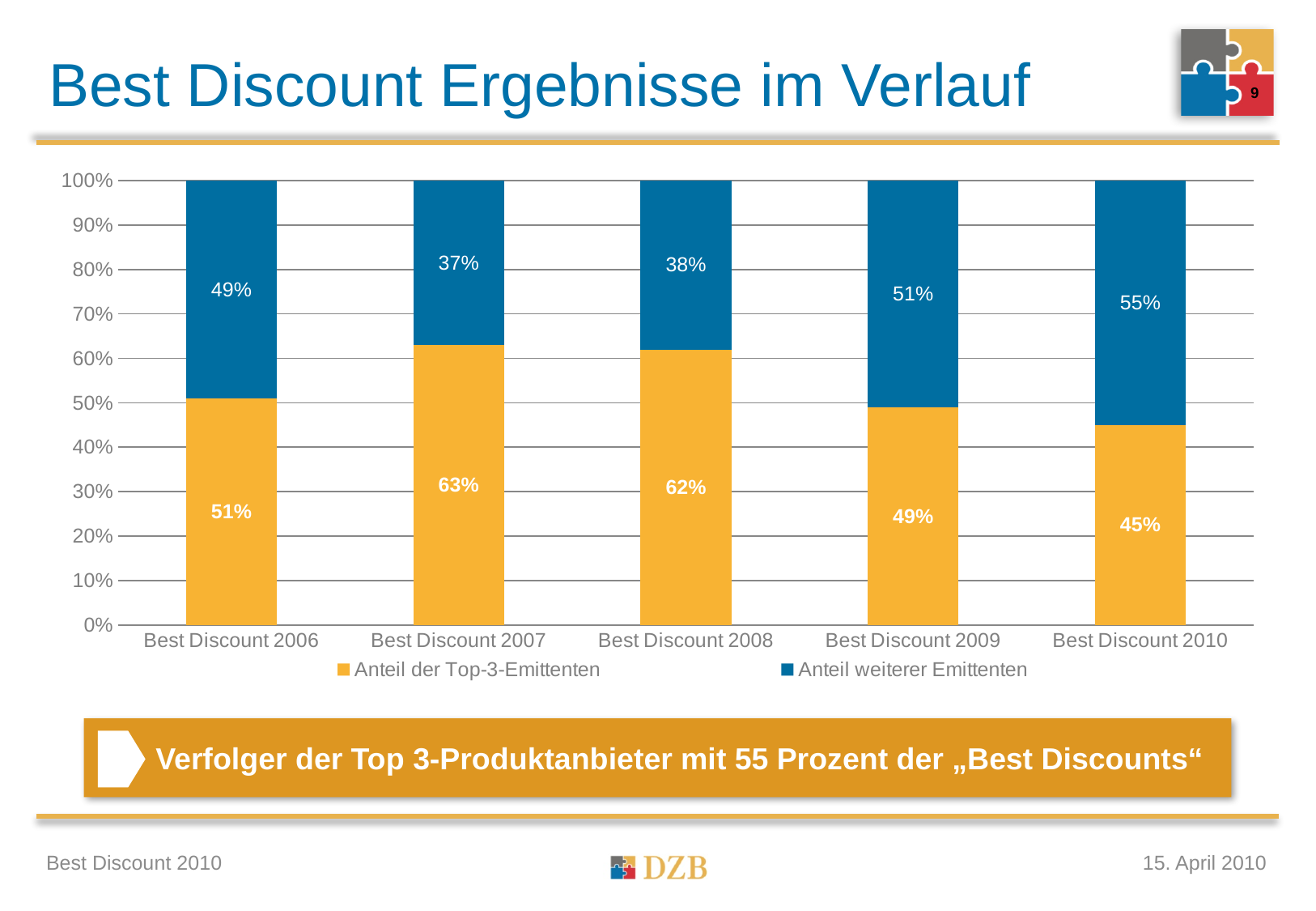
What is the value for Anteil weiterer Emittenten in Best Discount 2010? 55% In which year is the Anteil weiterer Emittenten lowest? Best Discount 2007 What is the difference between the Anteil der Top-3-Emittenten in Best Discount 2007 and Best Discount 2010? 18% What kind of chart is shown on the slide? Stacked bar chart What colour represents Anteil weiterer Emittenten in the chart? Blue What is the value for Anteil der Top-3-Emittenten in Best Discount 2009? 49% Which is larger: the Anteil weiterer Emittenten in Best Discount 2006 or in Best Discount 2008? Best Discount 2006 How many years (categories) are shown on the x axis? 5 What is the value for Anteil der Top-3-Emittenten in Best Discount 2007? 63% In which year is the Anteil der Top-3-Emittenten highest? Best Discount 2007 How many series does the legend list? 2 Does the Anteil der Top-3-Emittenten rise or fall from Best Discount 2008 to Best Discount 2010? Fall